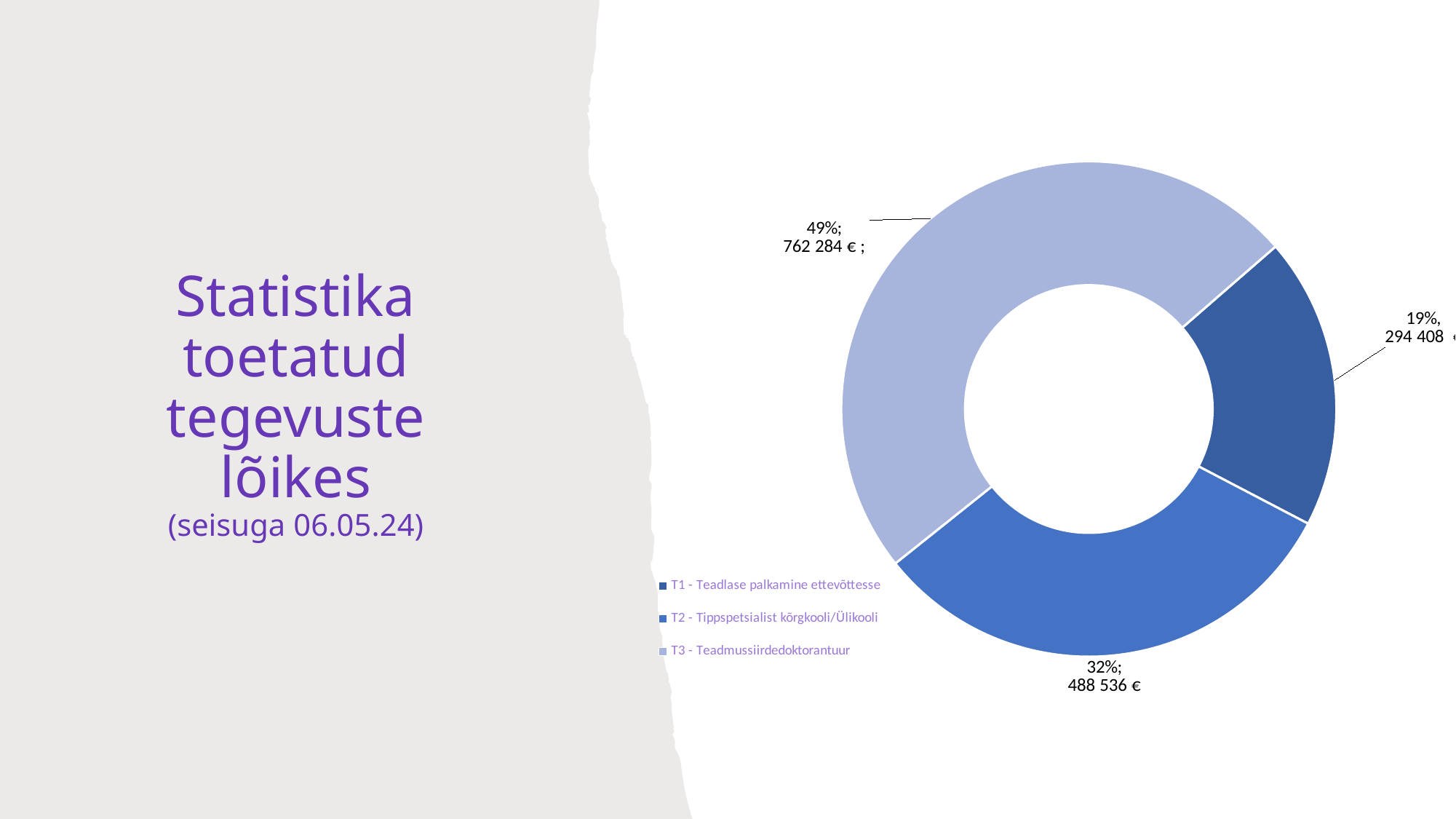
What percentage share does T3 - Teadmussiirdedoktorantuur have in the chart? 49% Which has the larger share, T2 - Tippspetsialist kõrgkooli/Ülikooli or T1 - Teadlase palkamine ettevõttesse? T2 - Tippspetsialist kõrgkooli/Ülikooli Which category has the largest share of the chart? T3 - Teadmussiirdedoktorantuur What percentage share does T2 - Tippspetsialist kõrgkooli/Ülikooli have? 32% How many entries does the chart legend list? 3 What kind of chart is shown on the slide? doughnut chart How much larger is the amount for T3 - Teadmussiirdedoktorantuur than for T2 - Tippspetsialist kõrgkooli/Ülikooli? 273 748 € What is the amount shown for T3 - Teadmussiirdedoktorantuur? 762 284 € What is the amount shown for T2 - Tippspetsialist kõrgkooli/Ülikooli? 488 536 € Which category has the smallest share of the chart? T1 - Teadlase palkamine ettevõttesse What percentage share does T1 - Teadlase palkamine ettevõttesse have? 19% How many slices does the doughnut chart have? 3